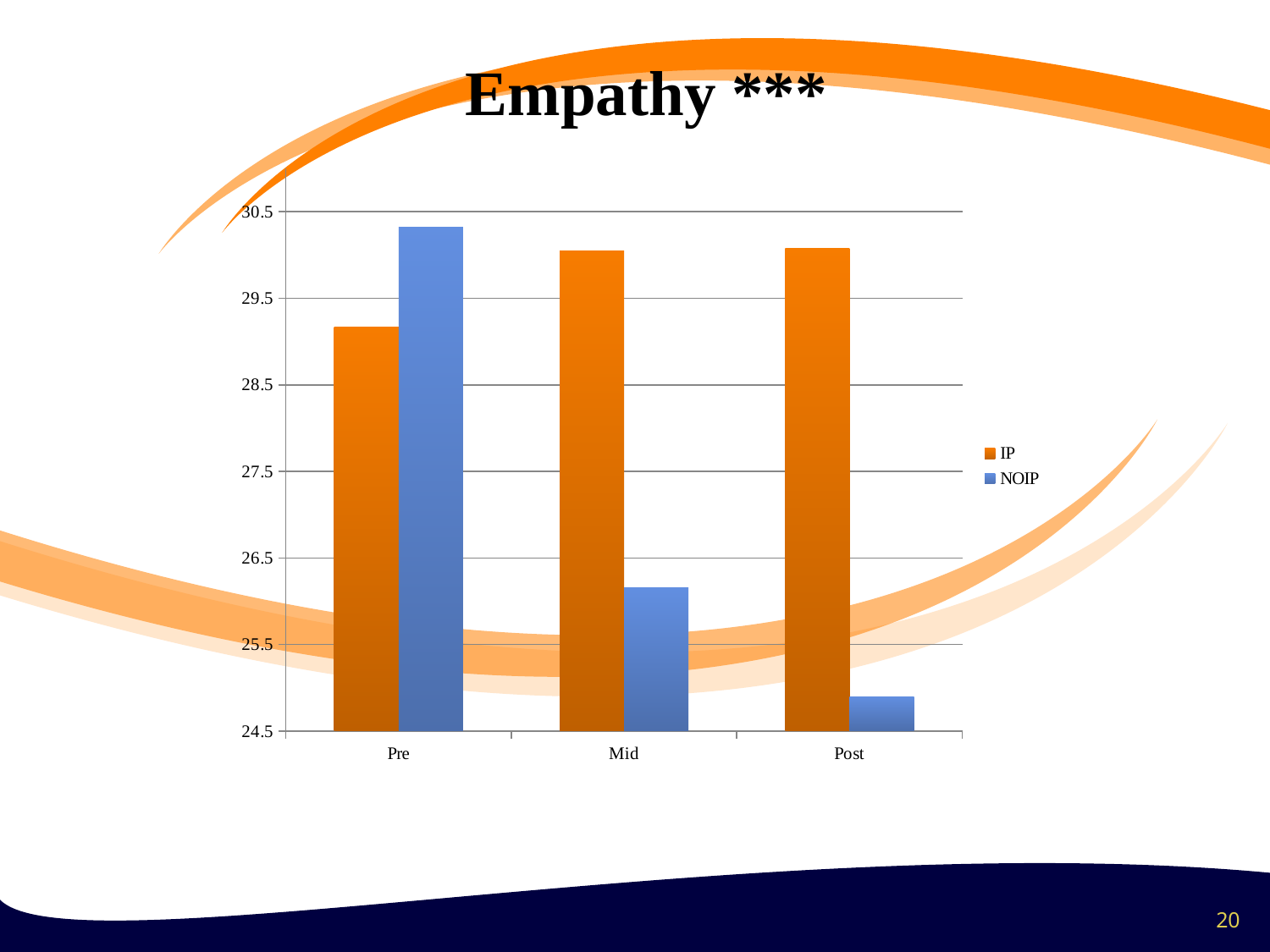
Which series is shown in blue in the legend? NOIP Is the value for NOIP at Post greater or less than 25.5? less Is the value for IP at Pre greater or less than 28.5? greater How many series does the legend list? 2 Is the value for NOIP at Pre greater or less than 29.5? greater What kind of chart is shown on the slide? bar chart At Pre, which series has the larger value, IP or NOIP? NOIP How many categories are shown on the x axis? 3 What is the title of the chart? Empathy *** At which category is the NOIP value lowest? Post Do the NOIP values rise or fall from Pre to Post? fall